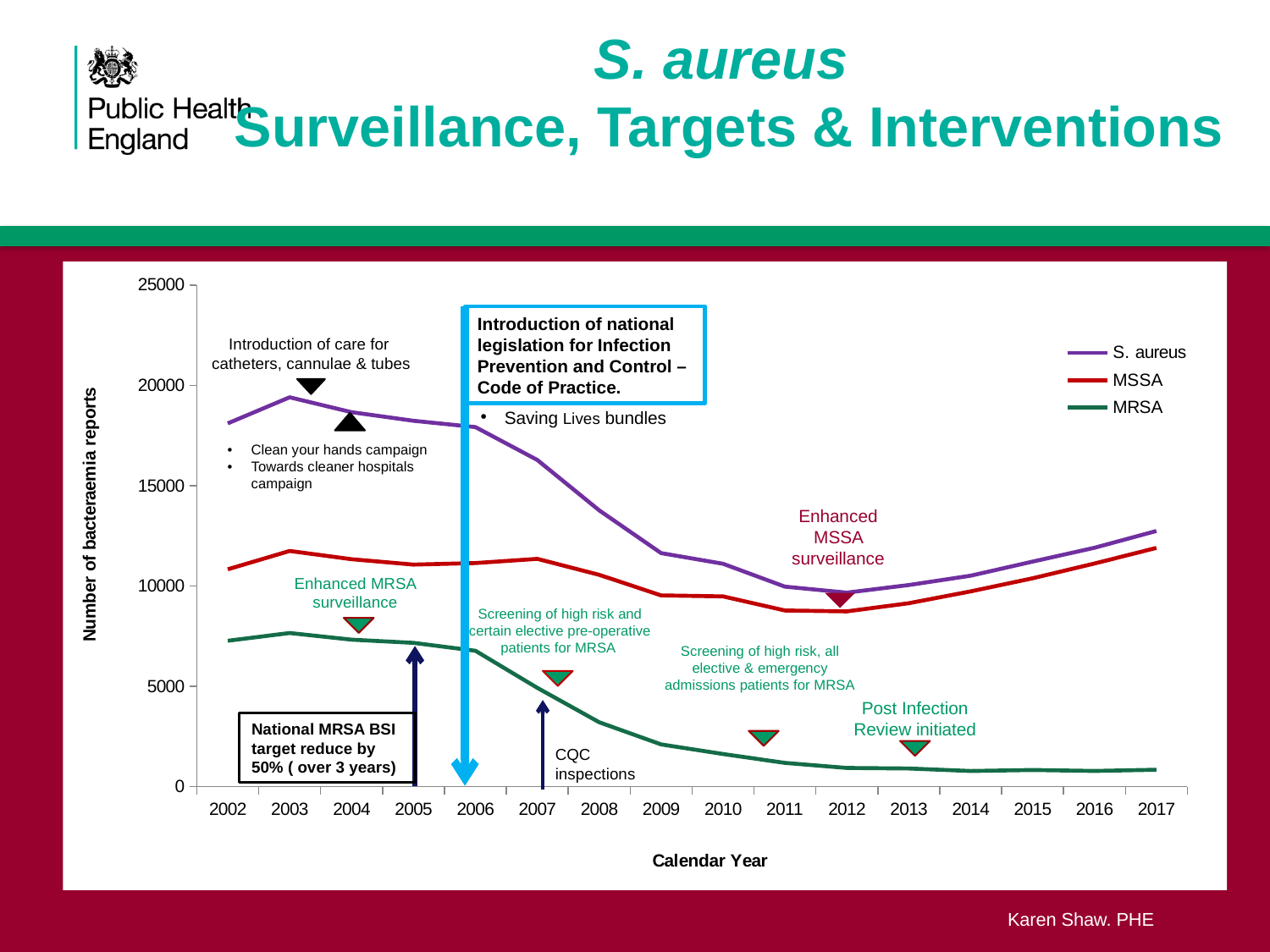
How many series does the legend list? 3 Does the MSSA line rise or fall from 2012 to 2017? rise What kind of chart is shown on the slide? line chart Is the value for S. aureus in 2003 greater or less than 15000? greater Which is larger: the MRSA value in 2003 or the MRSA value in 2009? 2003 Is the value for S. aureus in 2017 greater or less than 10000? greater How many calendar years are plotted along the x axis? 16 In 2002, which is larger: the S. aureus value or the MRSA value? S. aureus In which year is the S. aureus line at its highest? 2003 Does the MRSA line rise or fall from 2002 to 2017? fall Is the value for MRSA in 2017 greater or less than 5000? less What is the label on the y axis? Number of bacteraemia reports